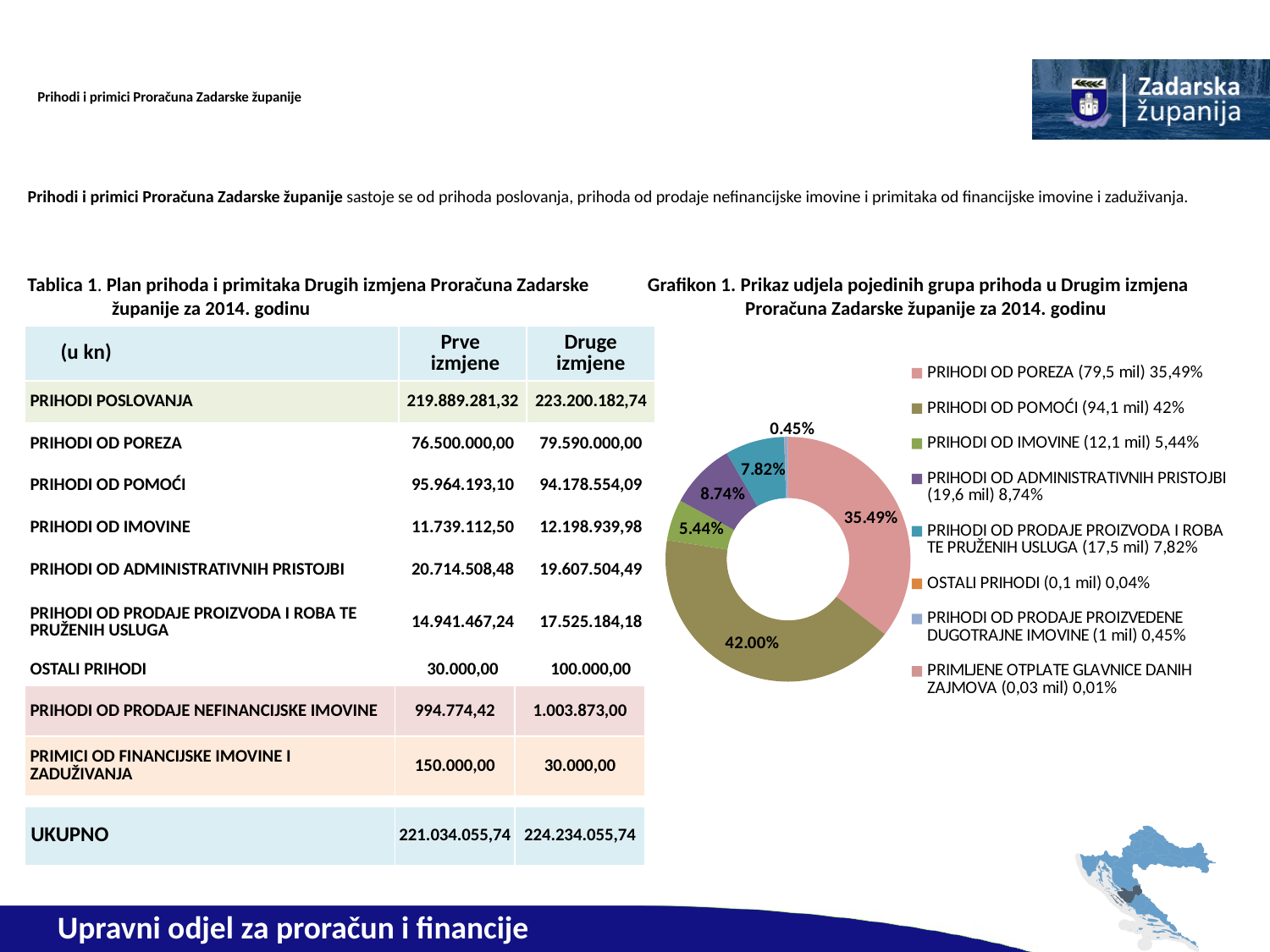
In Grafikon 1, which revenue group has the largest share? PRIHODI OD POMOĆI In Grafikon 1, which has the larger share: PRIHODI OD POREZA or PRIHODI OD POMOĆI? PRIHODI OD POMOĆI What kind of chart is Grafikon 1? Doughnut chart In Grafikon 1, what percentage share is shown for PRIHODI OD IMOVINE? 5.44% In Grafikon 1, by how many percentage points does the share of PRIHODI OD POMOĆI exceed that of PRIHODI OD POREZA? 6.51 percentage points What is the title of the chart on the slide? Grafikon 1. Prikaz udjela pojedinih grupa prihoda u Drugim izmjena Proračuna Zadarske županije za 2014. godinu How many entries does the legend of Grafikon 1 list? 8 In Grafikon 1, what percentage share is shown for PRIHODI OD ADMINISTRATIVNIH PRISTOJBI? 8.74% In Grafikon 1, what is the difference in percentage points between PRIHODI OD ADMINISTRATIVNIH PRISTOJBI and PRIHODI OD PRODAJE PROIZVODA I ROBA TE PRUŽENIH USLUGA? 0.92 percentage points In Grafikon 1, what percentage share is shown for PRIHODI OD POMOĆI? 42.00% In Grafikon 1, what percentage share is shown for PRIHODI OD POREZA? 35.49% In Grafikon 1, what percentage share is shown for PRIHODI OD PRODAJE PROIZVODA I ROBA TE PRUŽENIH USLUGA? 7.82%